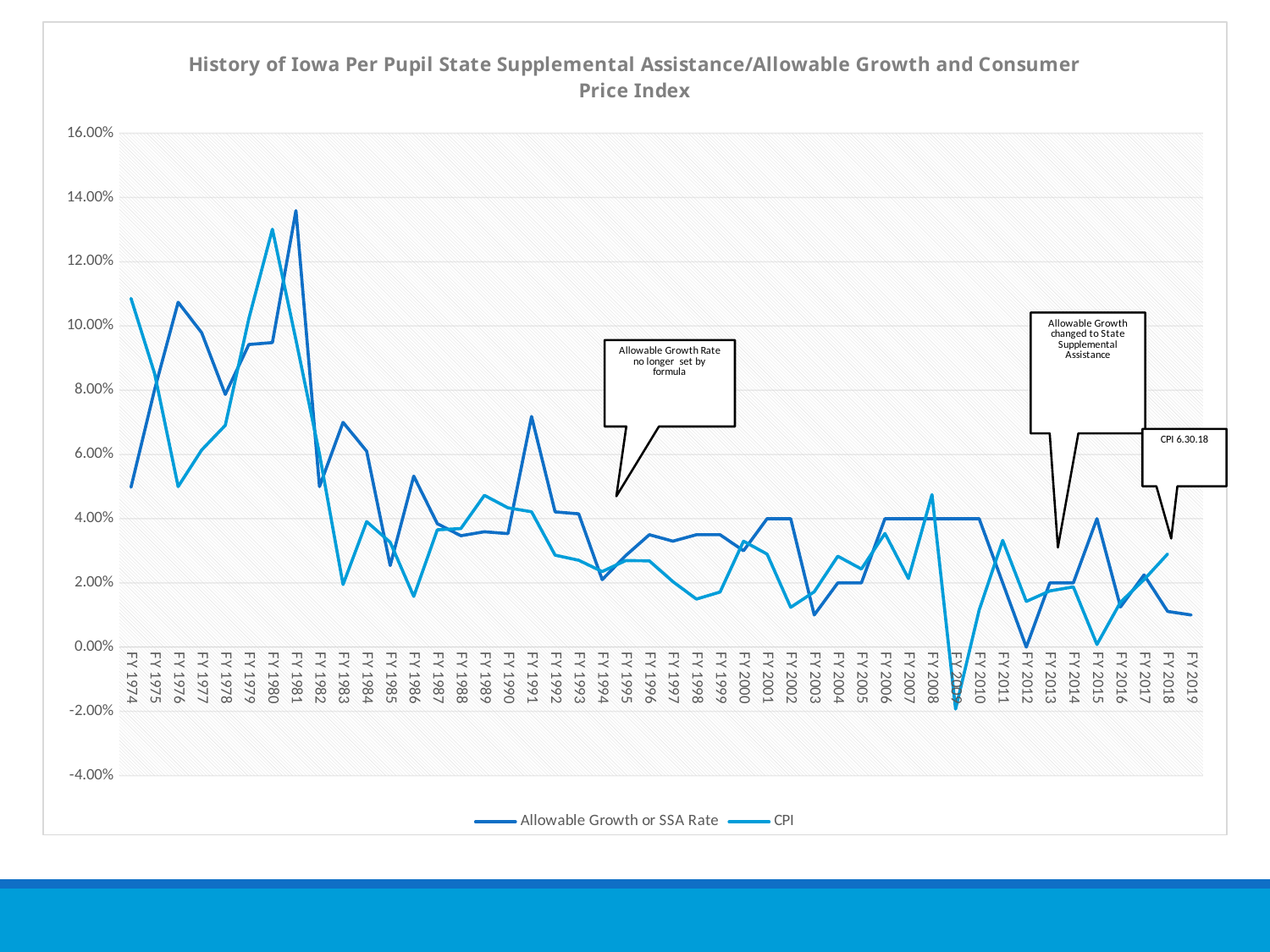
In FY 1974, which series has the larger value, Allowable Growth or SSA Rate or CPI? CPI Is the CPI value for FY 2009 greater or less than 0.00%? less Is the Allowable Growth or SSA Rate value for FY 2012 greater or less than 2.00%? less What kind of chart is shown on the slide? Line chart What are the two series named in the legend? Allowable Growth or SSA Rate and CPI How many series does the legend list? 2 Does the Allowable Growth or SSA Rate series generally rise or fall from FY 1974 to FY 2019? Fall How many fiscal years are plotted along the x axis? 46 Is the Allowable Growth or SSA Rate value for FY 1981 greater or less than 12.00%? greater In which fiscal year does the CPI series reach its highest value? FY 1980 In which fiscal year does the Allowable Growth or SSA Rate series reach its highest value? FY 1981 In which fiscal year does the CPI series reach its lowest value? FY 2009